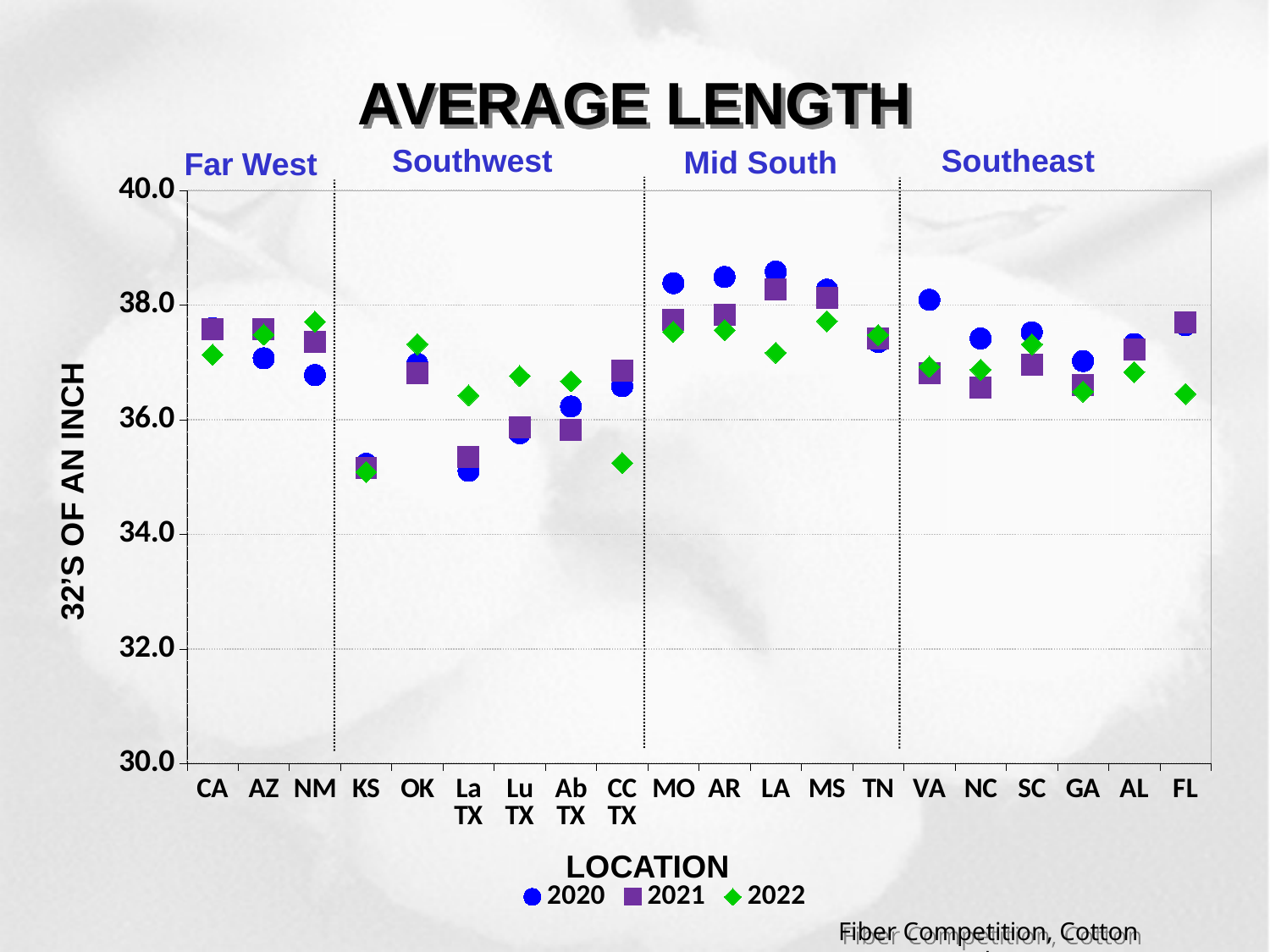
What kind of chart is shown on the slide? Scatter (dot) chart Is the 2020 value for LA greater or less than 38.0? greater Is the 2022 value for MS greater or less than 38.0? less How many series does the legend list? 3 How many locations are plotted along the x axis? 20 Is the 2020 value for KS greater or less than 36.0? less Which location has the highest 2020 value? LA At VA, which is larger: the 2020 value or the 2022 value? 2020 At La TX, which is larger: the 2020 value or the 2022 value? 2022 What is the label on the y axis? 32'S OF AN INCH